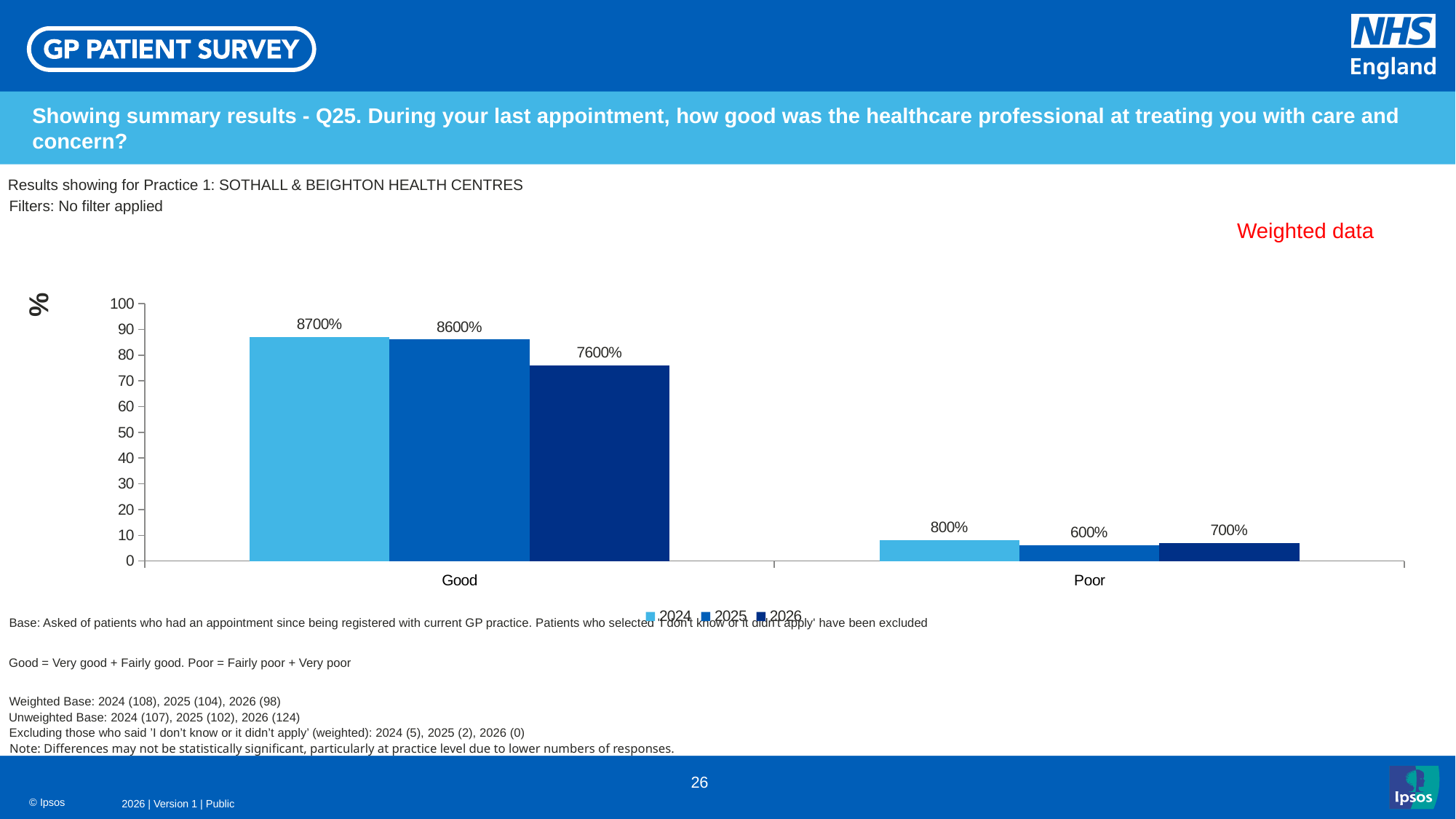
Is the 2026 bar in the Good category greater or less than 70 on the y axis? greater What is the data label shown for the 2024 series in the Poor category? 800% Which year has the highest bar in the Good category? 2024 What is the data label shown for the 2026 series in the Good category? 7600% Which year has the lowest bar in the Poor category? 2025 How many series does the legend list? 3 Which is larger in the Good category: the 2025 bar or the 2026 bar? 2025 How many categories are shown on the x axis? 2 What kind of chart is shown on the slide? bar chart What are the series names listed in the legend? 2024, 2025, 2026 What is the data label shown for the 2025 series in the Poor category? 600% What is the data label shown for the 2024 series in the Good category? 8700%